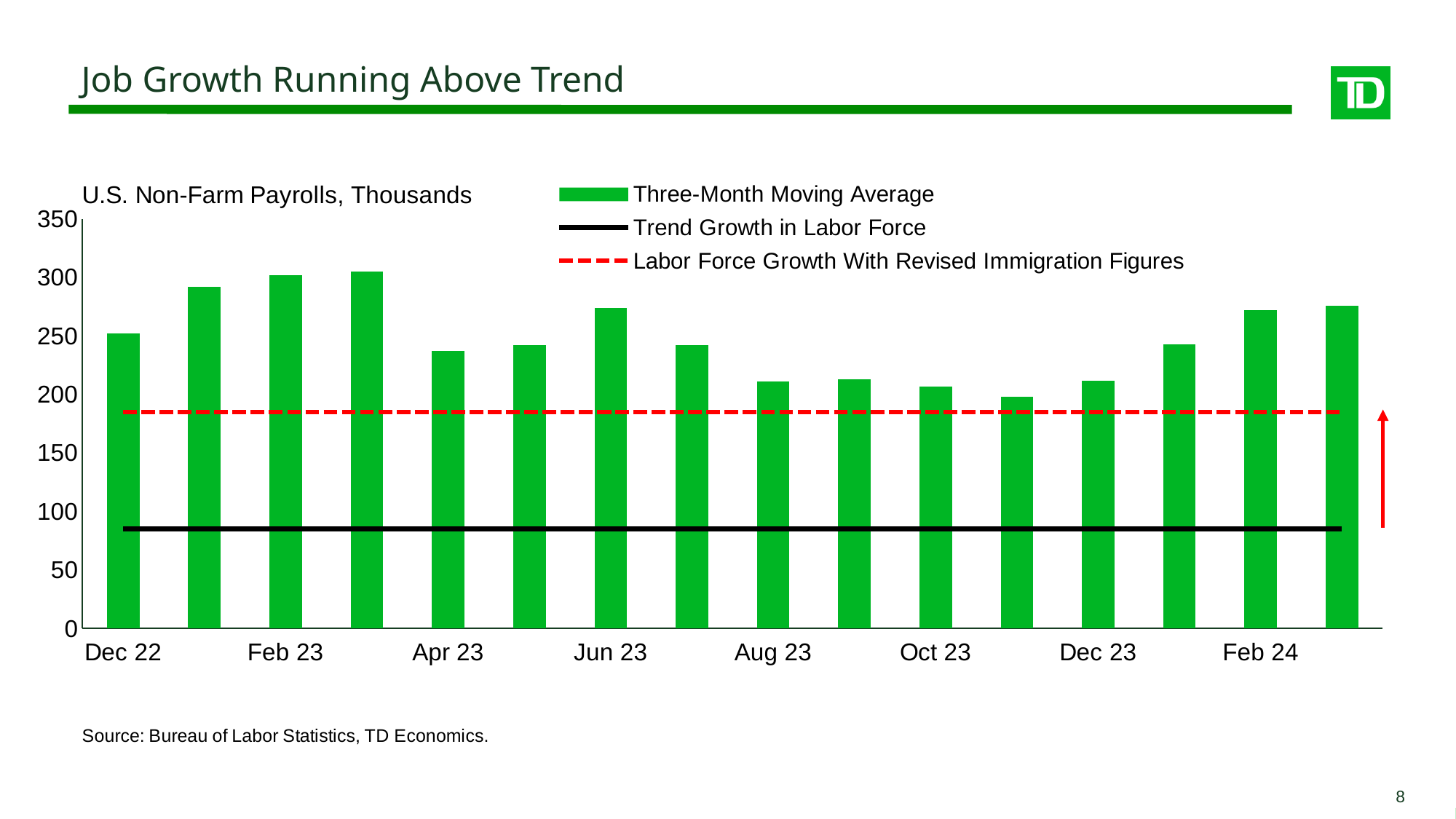
How many series does the legend list? 3 Is the value for Feb 24 greater or less than 250? greater How many bars are plotted in the chart? 16 What kind of chart is shown on the slide? Combination bar and line chart Do the bar values rise or fall from Feb 23 to Oct 23? fall Is the value for Feb 23 greater or less than 250? greater Is the value for Aug 23 greater or less than 200? greater Which is larger, the value for Jun 23 or the value for Aug 23? Jun 23 Which legend entry is shown as a red dashed line? Labor Force Growth With Revised Immigration Figures Which is larger, the value for Feb 23 or the value for Apr 23? Feb 23